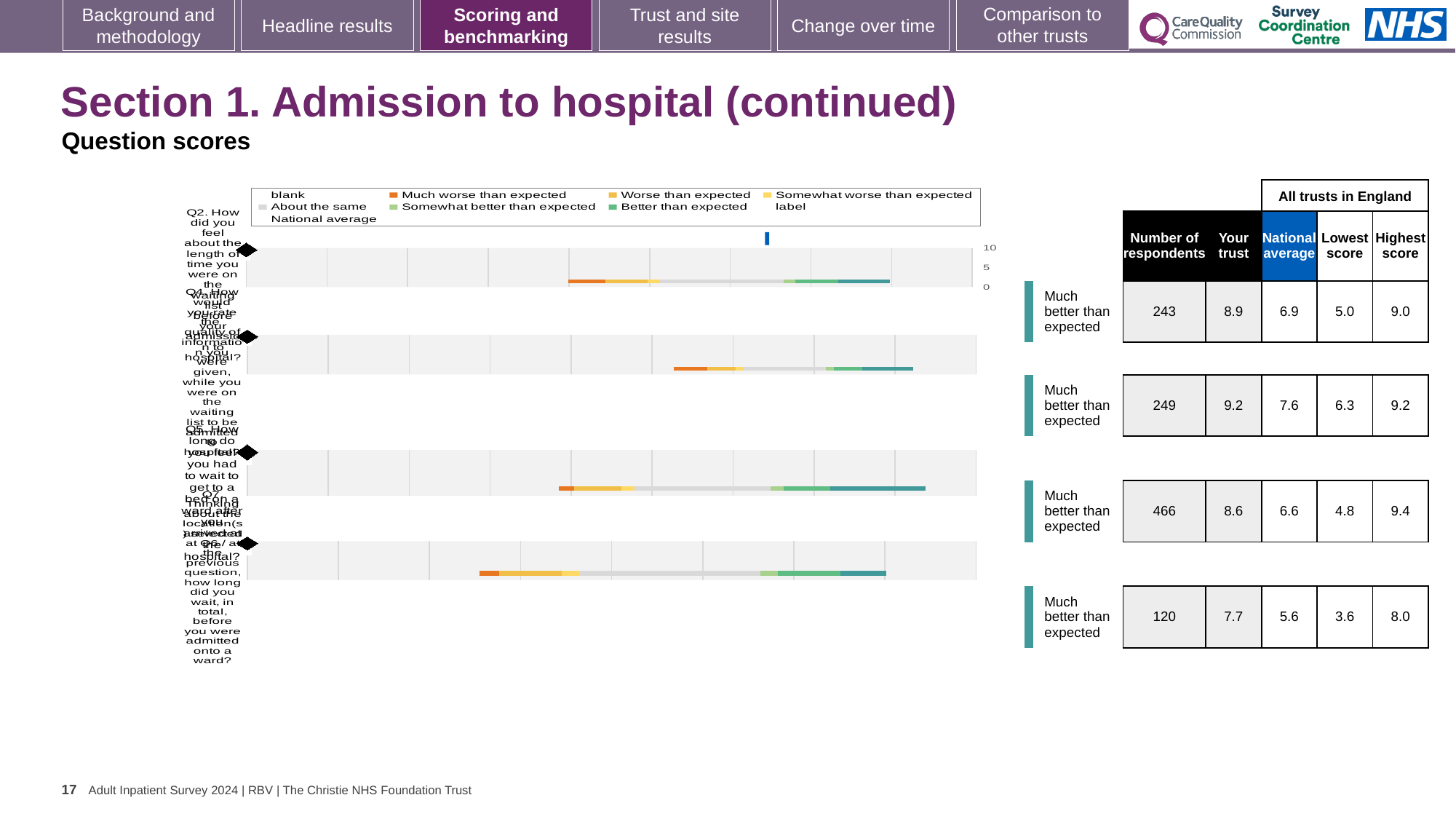
In the fourth chart row (Q7, total wait before being admitted onto a ward), what is the highest score among all trusts in England? 8.0 In the third chart row (Q5), what is the lowest score among all trusts in England? 4.8 In the first chart row (Q2, length of time on the waiting list), what is the 'Your trust' score? 8.9 In the fourth chart row (Q7), what is the difference between the 'Your trust' score and the national average? 2.1 In the third chart row (Q5), is the 'Your trust' score higher or lower than the national average? Higher How many question chart rows are shown on the slide? 4 In the third chart row (Q5, wait to get to a bed on a ward), how many respondents are there? 466 What benchmark category is shown for all four question chart rows? Much better than expected In the second chart row (Q4, quality of information while on the waiting list), what is the national average score? 7.6 Which chart row has the lowest 'Your trust' score? Fourth row (Q7), 7.7 In the first chart row (Q2), what is the difference between the 'Your trust' score and the national average? 2.0 Which chart row has the highest 'Your trust' score? Second row (Q4), 9.2